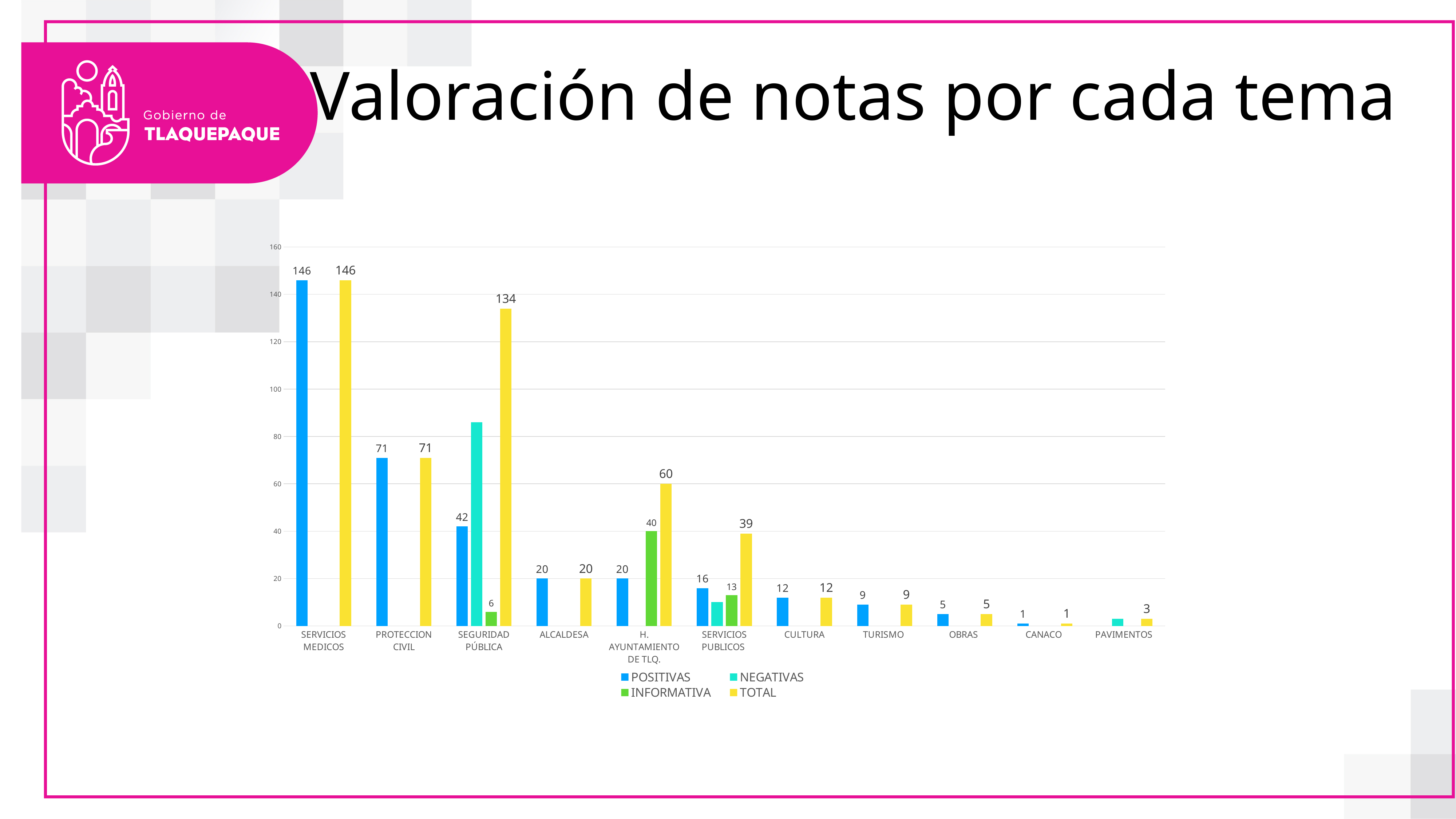
How many series does the legend list? 4 What is the POSITIVAS value for SERVICIOS PUBLICOS? 16 Which has a larger POSITIVAS value, PROTECCION CIVIL or SEGURIDAD PÚBLICA? PROTECCION CIVIL How many categories are shown on the x axis? 11 Which category has the lowest TOTAL value? CANACO Is the NEGATIVAS value for SEGURIDAD PÚBLICA greater or less than 80? greater What is the difference between the TOTAL for SERVICIOS MEDICOS and the TOTAL for SEGURIDAD PÚBLICA? 12 What is the TOTAL value for SEGURIDAD PÚBLICA? 134 What is the title of the slide? Valoración de notas por cada tema What kind of chart is shown on the slide? bar chart What is the INFORMATIVA value for H. AYUNTAMIENTO DE TLQ.? 40 Which category has the highest TOTAL value? SERVICIOS MEDICOS